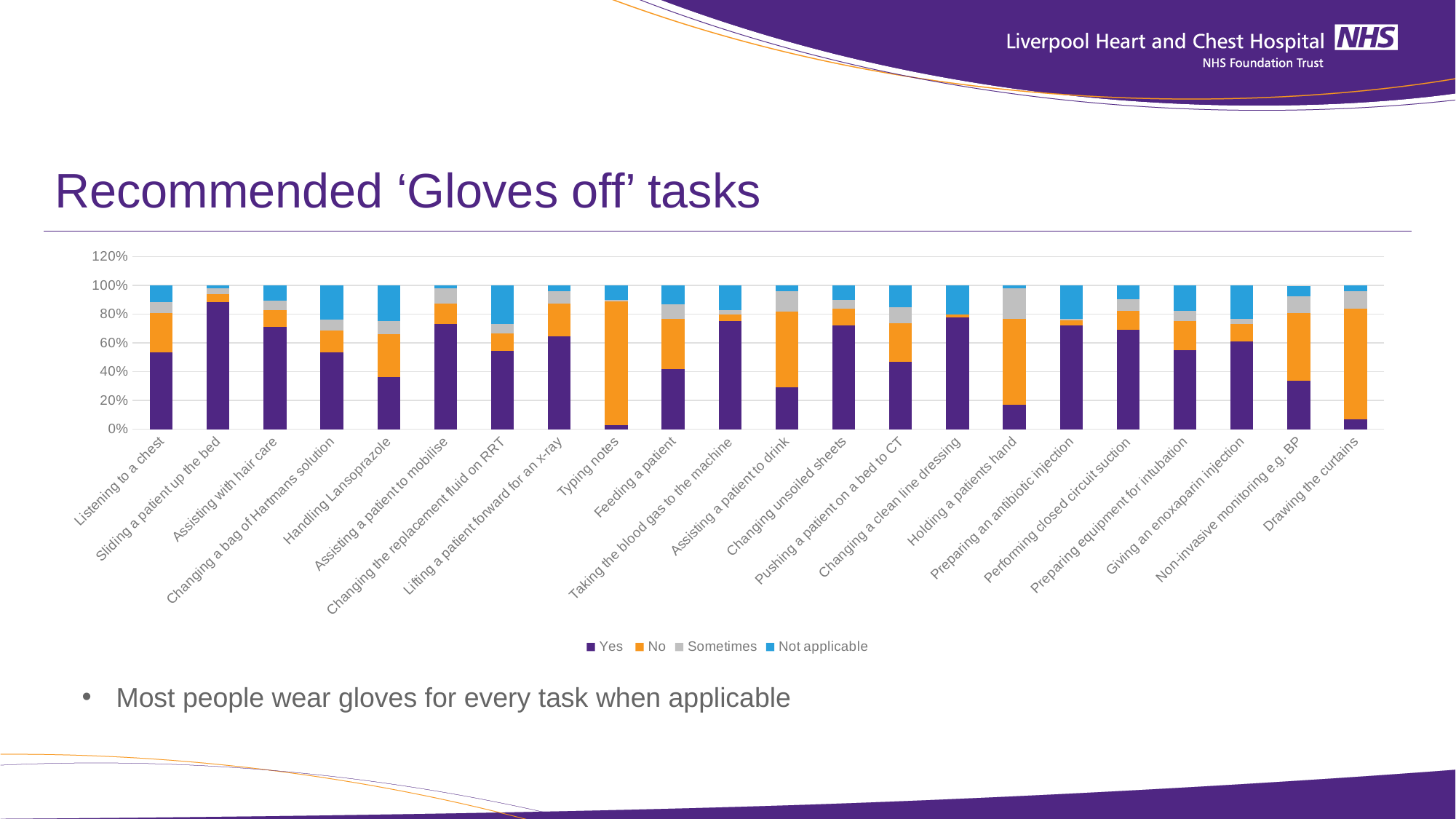
What is the total height of the stacked bar for Drawing the curtains? 100% How many tasks (categories) are plotted along the x axis? 22 Which has the larger 'Yes' share: Feeding a patient or Taking the blood gas to the machine? Taking the blood gas to the machine Is the 'Yes' value for Handling Lansoprazole greater or less than 40%? less Which task has the largest 'Yes' share? Sliding a patient up the bed Which task has the largest 'No' share? Typing notes Which task has the smallest 'Yes' share? Typing notes Is the 'Yes' value for Listening to a chest greater or less than 40%? greater Which series are listed in the legend? Yes, No, Sometimes, Not applicable What kind of chart is shown on the slide? Stacked bar chart How many series does the legend list? 4 Is the 'Yes' value for Holding a patients hand greater or less than 20%? less